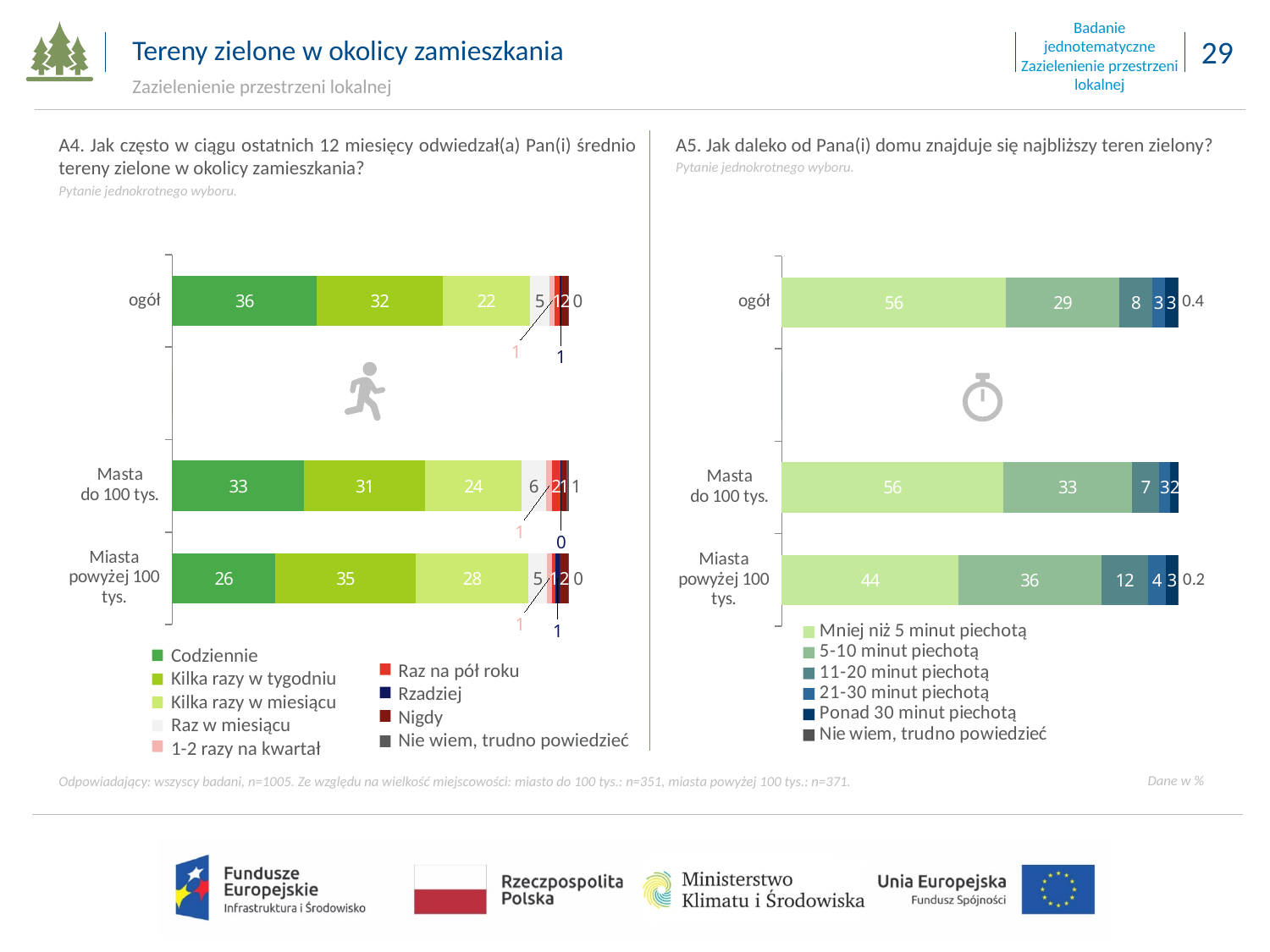
In the A4 chart on the left, how many legend entries are listed? 9 In the A4 chart on the left, which of the three groups has the highest value for 'Codziennie'? ogół In the A4 chart on the left, what is the difference between the 'Codziennie' values for 'Masta do 100 tys.' and 'Miasta powyżej 100 tys.'? 7 In the A5 chart on the right, which group has the lowest value for 'Mniej niż 5 minut piechotą'? Miasta powyżej 100 tys. In the A5 chart on the right, what is the difference between the '5-10 minut piechotą' values for 'Miasta powyżej 100 tys.' and 'ogół'? 7 How many groups (bars) are shown in the A5 chart on the right? 3 What type of chart is the A4 chart on the left? Stacked bar chart In the A5 chart on the right, is the '5-10 minut piechotą' value larger for 'Masta do 100 tys.' or for 'Miasta powyżej 100 tys.'? Miasta powyżej 100 tys. In the A5 chart on the right, what is the value for '11-20 minut piechotą' for 'Miasta powyżej 100 tys.'? 12 In the A5 chart on the right, what percentage of the 'ogół' group answered 'Mniej niż 5 minut piechotą'? 56 In the A4 chart on the left, what percentage of the 'ogół' group answered 'Codziennie'? 36 In the A4 chart on the left, what is the value for 'Kilka razy w miesiącu' for 'Miasta powyżej 100 tys.'? 28